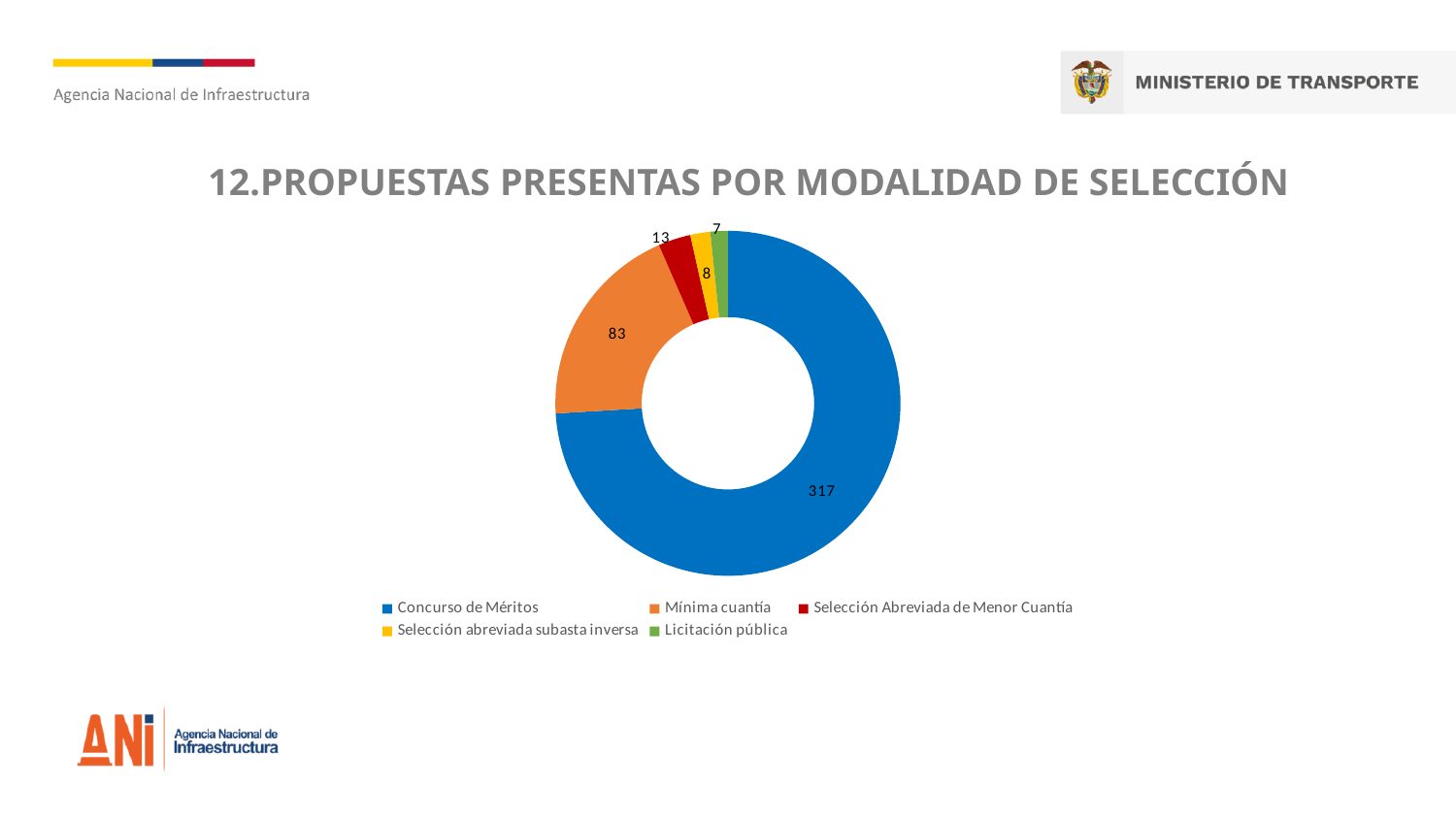
Which is larger, the value for Mínima cuantía or the value for Selección Abreviada de Menor Cuantía? Mínima cuantía What type of chart is shown on the slide? Doughnut (pie) chart Which selection modality has the lowest number of proposals? Licitación pública What is the value for Licitación pública? 7 How many categories does the legend list? 5 What is the value for Concurso de Méritos? 317 Which selection modality has the highest number of proposals? Concurso de Méritos What is the title of the chart? 12.PROPUESTAS PRESENTAS POR MODALIDAD DE SELECCIÓN What is the value for Mínima cuantía? 83 What is the value for Selección abreviada subasta inversa? 8 What is the value for Selección Abreviada de Menor Cuantía? 13 What is the difference between the values for Concurso de Méritos and Mínima cuantía? 234